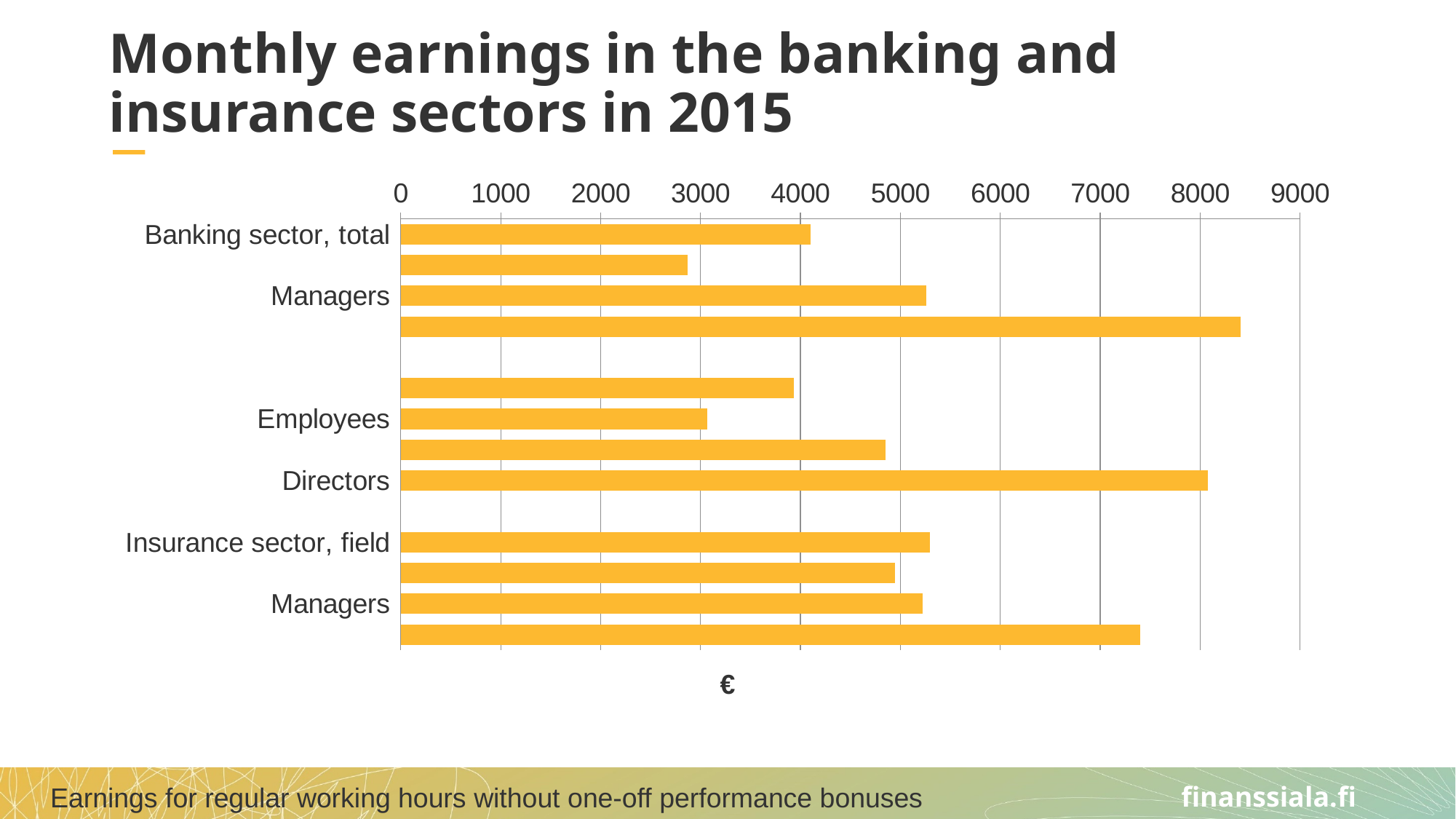
Is the value for Directors greater or less than 9000? less Which is larger, the value for Directors or the value for Banking sector, total? Directors Is the value for Insurance sector, field greater or less than 5000? greater Is the value for Directors greater or less than 7000? greater What kind of chart is shown on the slide? bar chart What unit is shown on the horizontal axis of the chart? € What is the title of the chart on the slide? Monthly earnings in the banking and insurance sectors in 2015 Which is larger, the value for Employees or the value for Banking sector, total? Banking sector, total How many bars are plotted in the chart? 12